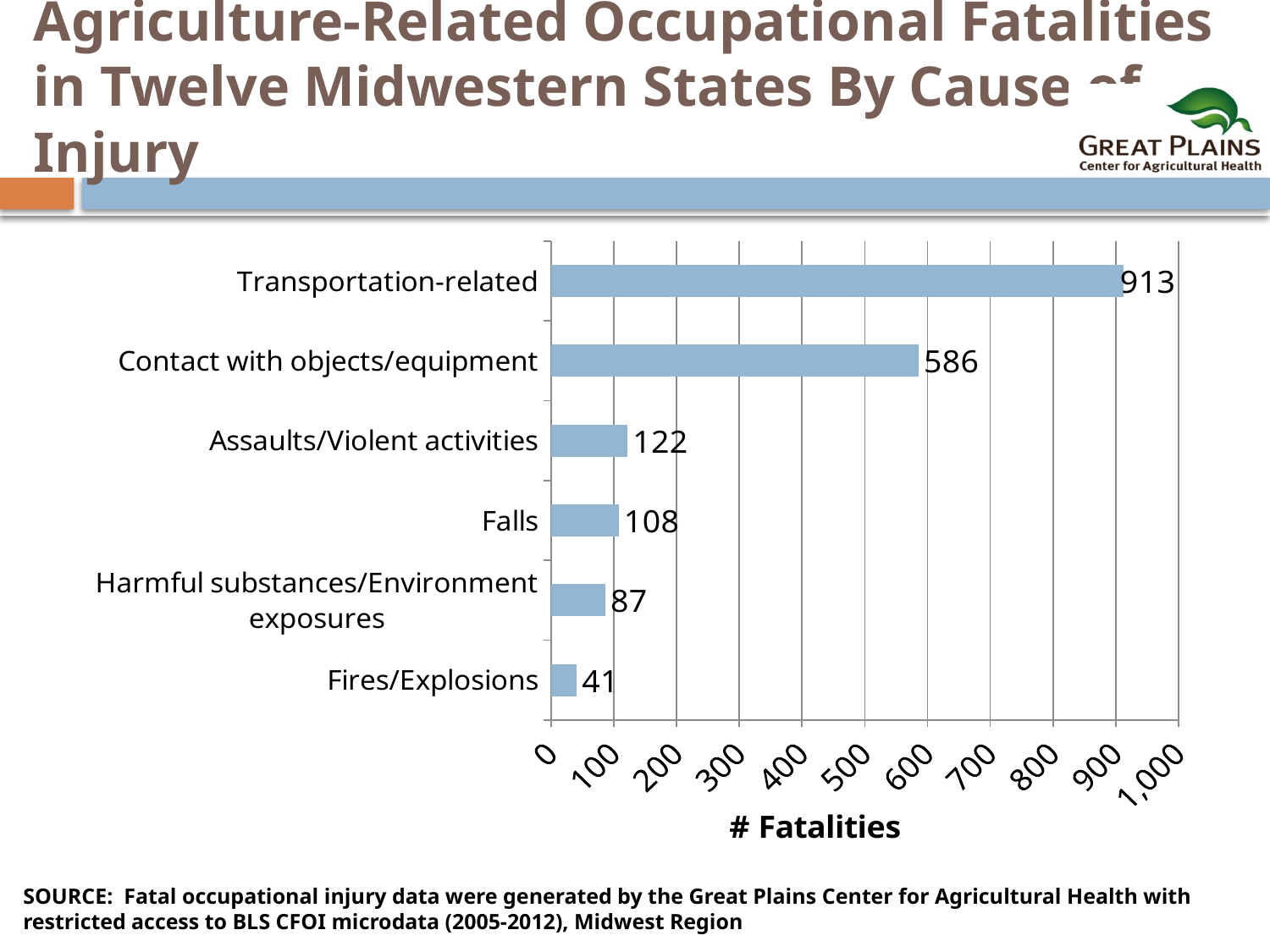
Which has more fatalities: Harmful substances/Environment exposures or Fires/Explosions? Harmful substances/Environment exposures How many fatalities are attributed to Falls? 108 What type of chart is shown on the slide? Bar chart What is the difference in fatalities between Assaults/Violent activities and Falls? 14 What is the difference in fatalities between Transportation-related and Contact with objects/equipment? 327 What is the number of fatalities for Contact with objects/equipment? 586 What is the value for Fires/Explosions? 41 How many causes of injury are shown in the chart? 6 How many fatalities are shown for Transportation-related causes? 913 Which cause of injury has the highest number of fatalities? Transportation-related Which cause of injury has the lowest number of fatalities? Fires/Explosions What is the label of the horizontal axis? # Fatalities